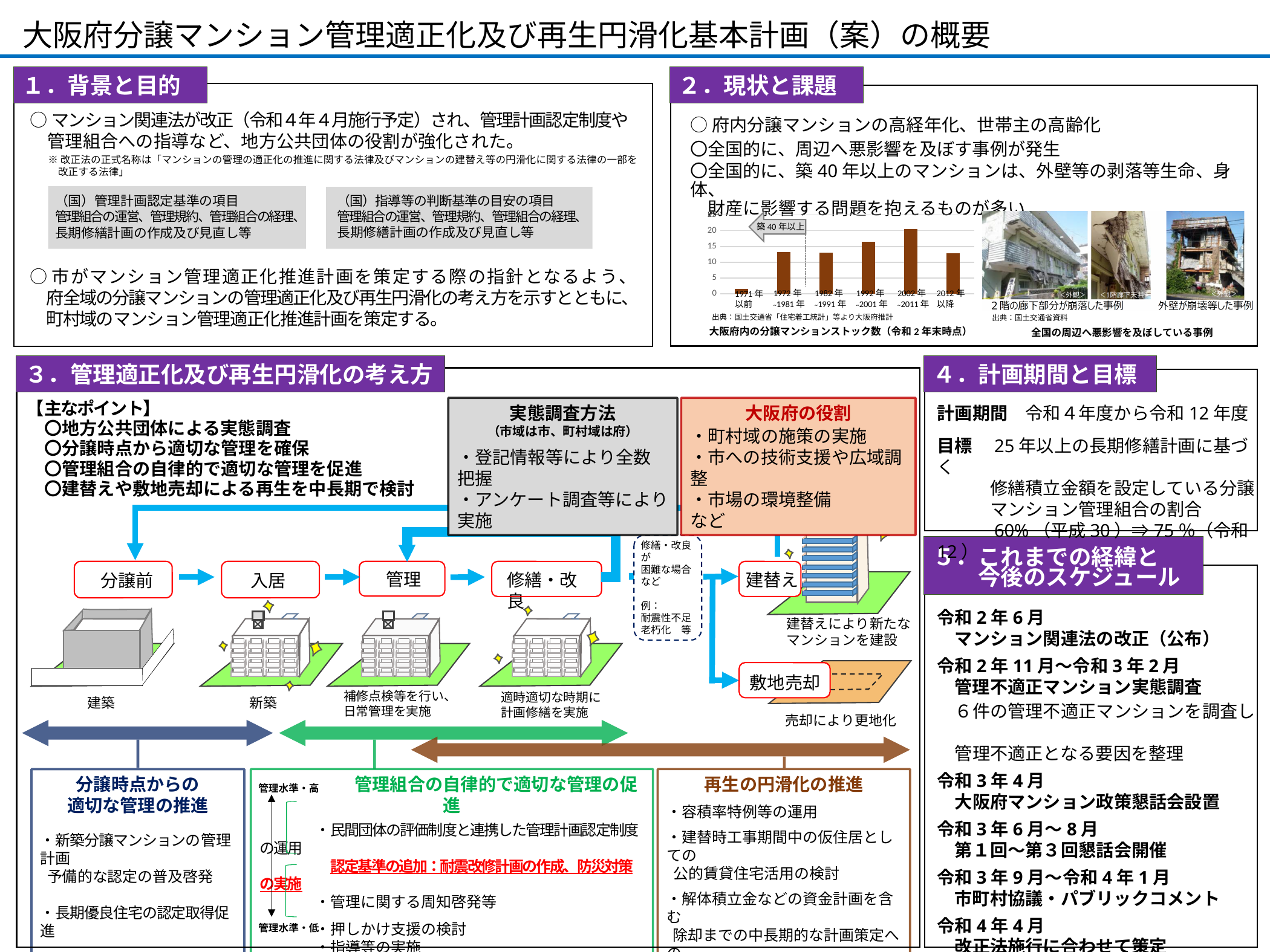
In the bar chart 「大阪府内の分譲マンションストック数」, which is larger: the value for 1992年～2001年 or the value for 1982年～1991年? 1992年～2001年 In the bar chart 「大阪府内の分譲マンションストック数」, is the value for 2002年～2011年 greater or less than 15? greater In the bar chart 「大阪府内の分譲マンションストック数」, is the value for 2012年以降 greater or less than 15? less How many categories (construction periods) are shown on the x axis of the bar chart 「大阪府内の分譲マンションストック数」? 6 In the bar chart 「大阪府内の分譲マンションストック数」, which is larger: the value for 2002年～2011年 or the value for 1971年以前? 2002年～2011年 In the bar chart 「大阪府内の分譲マンションストック数」, which construction period has the highest bar? 2002年～2011年 In the bar chart 「大阪府内の分譲マンションストック数」, which construction period has the lowest bar? 1971年以前 In the bar chart 「大阪府内の分譲マンションストック数」, is the value for 1992年～2001年 greater or less than 15? greater What is the title of the bar chart in the section 「２．現状と課題」? 大阪府内の分譲マンションストック数（令和２年末時点） What kind of chart is shown in the section 「２．現状と課題」? bar chart